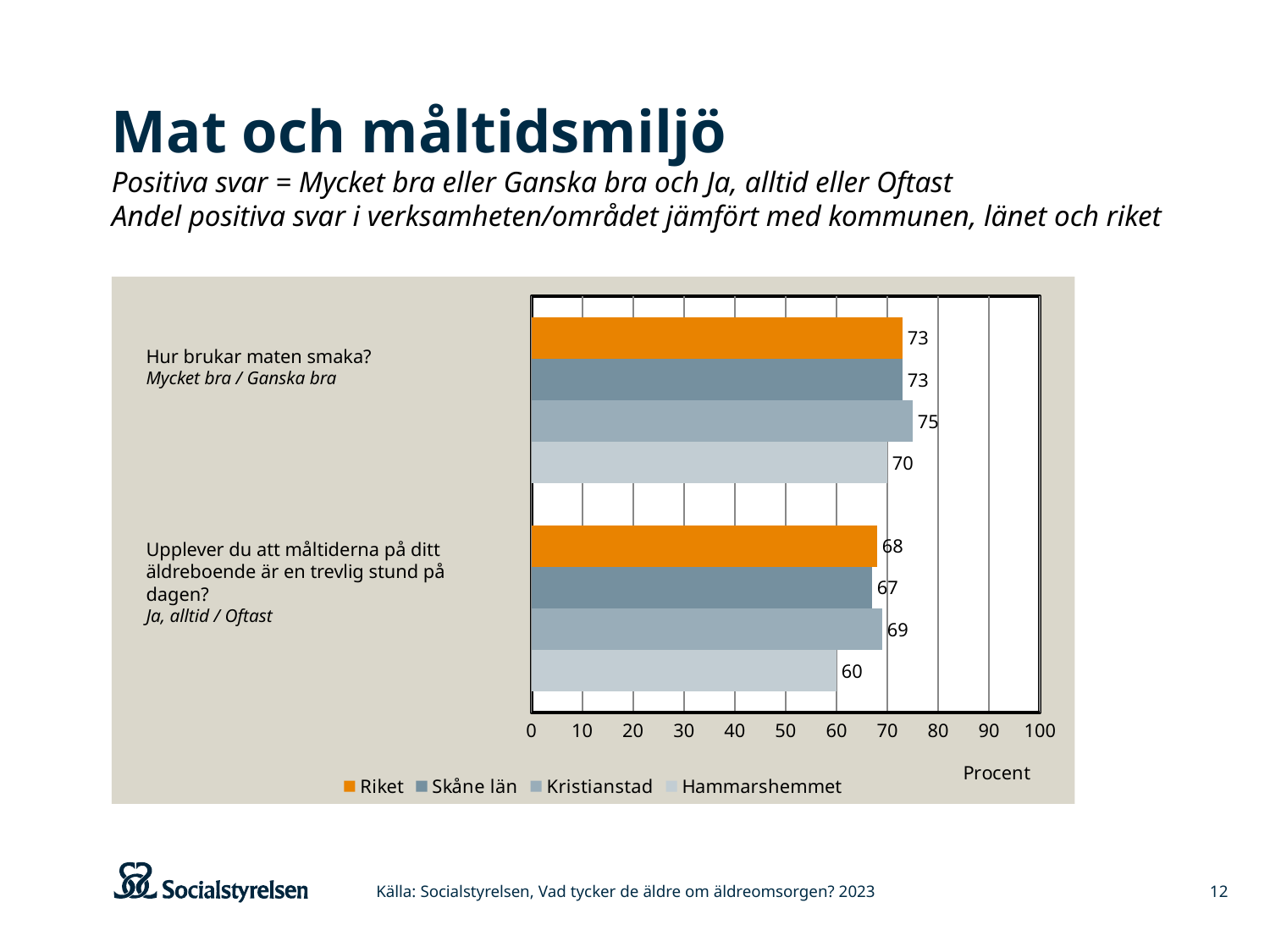
Which series has the lowest value for the question "Upplever du att måltiderna på ditt äldreboende är en trevlig stund på dagen?"? Hammarshemmet What unit is shown on the horizontal axis of the chart? Procent What is the value for Hammarshemmet for the question "Upplever du att måltiderna på ditt äldreboende är en trevlig stund på dagen?"? 60 What is the value for Kristianstad for the question "Hur brukar maten smaka?"? 75 Which is larger for Skåne län: the value for "Hur brukar maten smaka?" or the value for "Upplever du att måltiderna på ditt äldreboende är en trevlig stund på dagen?"? Hur brukar maten smaka? What is the difference between Kristianstad and Hammarshemmet for the question "Upplever du att måltiderna på ditt äldreboende är en trevlig stund på dagen?"? 9 Which series has the highest value for the question "Hur brukar maten smaka?"? Kristianstad What is the value for Hammarshemmet for the question "Hur brukar maten smaka?"? 70 What is the difference between Kristianstad and Hammarshemmet for the question "Hur brukar maten smaka?"? 5 How many series does the legend list? 4 What kind of chart is shown on the slide? Bar chart What is the value for Riket for the question "Upplever du att måltiderna på ditt äldreboende är en trevlig stund på dagen?"? 68